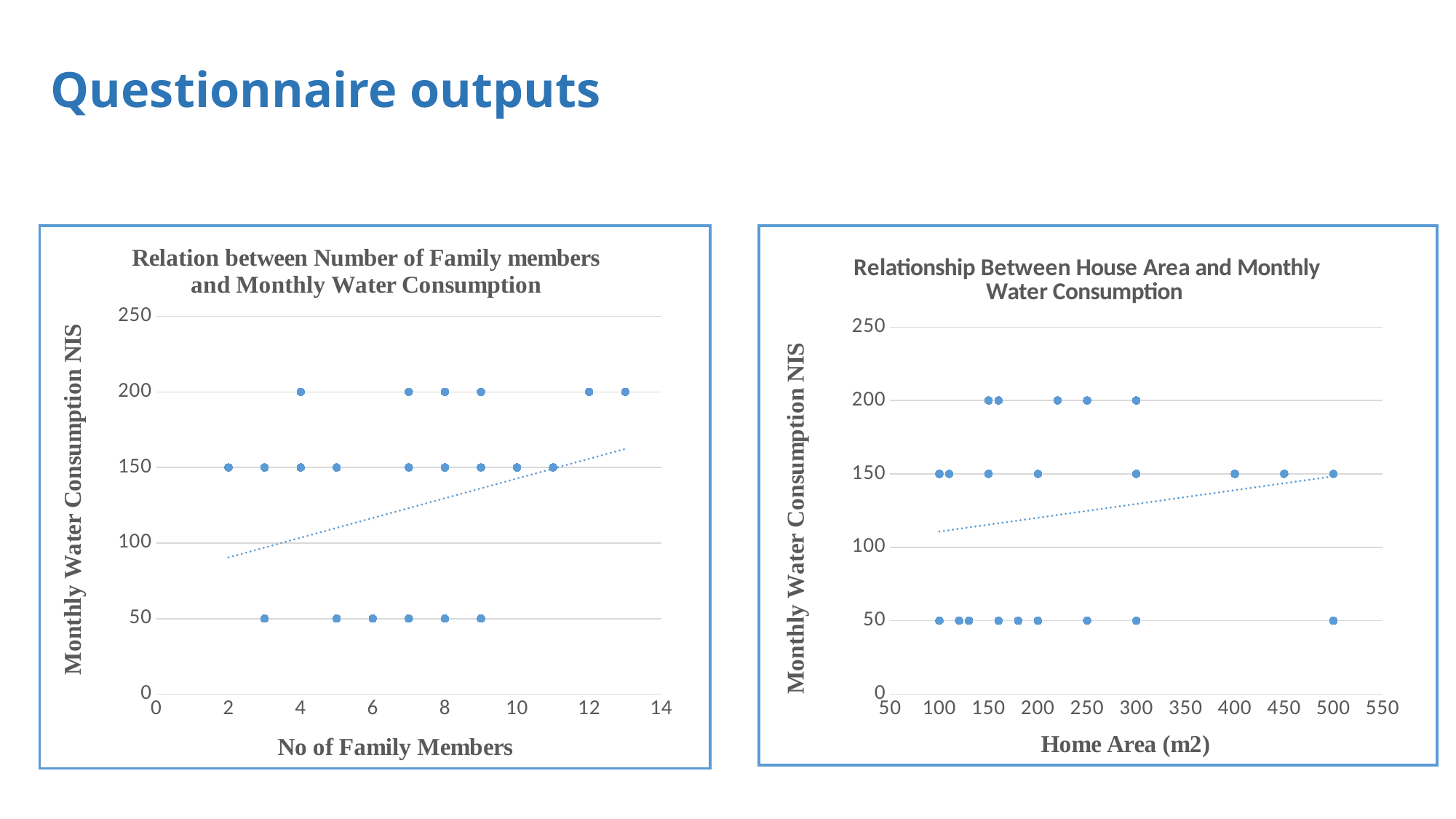
In the left chart, what is the monthly water consumption for the household with 13 family members? 200 In the left chart, how many points are plotted at a monthly water consumption of 200? 6 In the left chart, what is the highest monthly water consumption value plotted? 200 In the right chart, what is the lowest monthly water consumption value plotted? 50 In the left chart, does the dotted trend line rise or fall as the number of family members increases? Rises In the right chart, is the value for the home with an area of 400 m2 greater or less than 100? greater In the left chart, what is the monthly water consumption for the household with 2 family members? 150 In the right chart, does the dotted trend line rise or fall as home area increases? Rises In the right chart, 'Relationship Between House Area and Monthly Water Consumption', what is the monthly water consumption for the home with an area of 450 m2? 150 What kind of chart is the left chart, 'Relation between Number of Family members and Monthly Water Consumption'? Scatter chart In the left chart, is the value for the household with 6 family members greater or less than 100? less What is the x-axis title of the right chart? Home Area (m2)